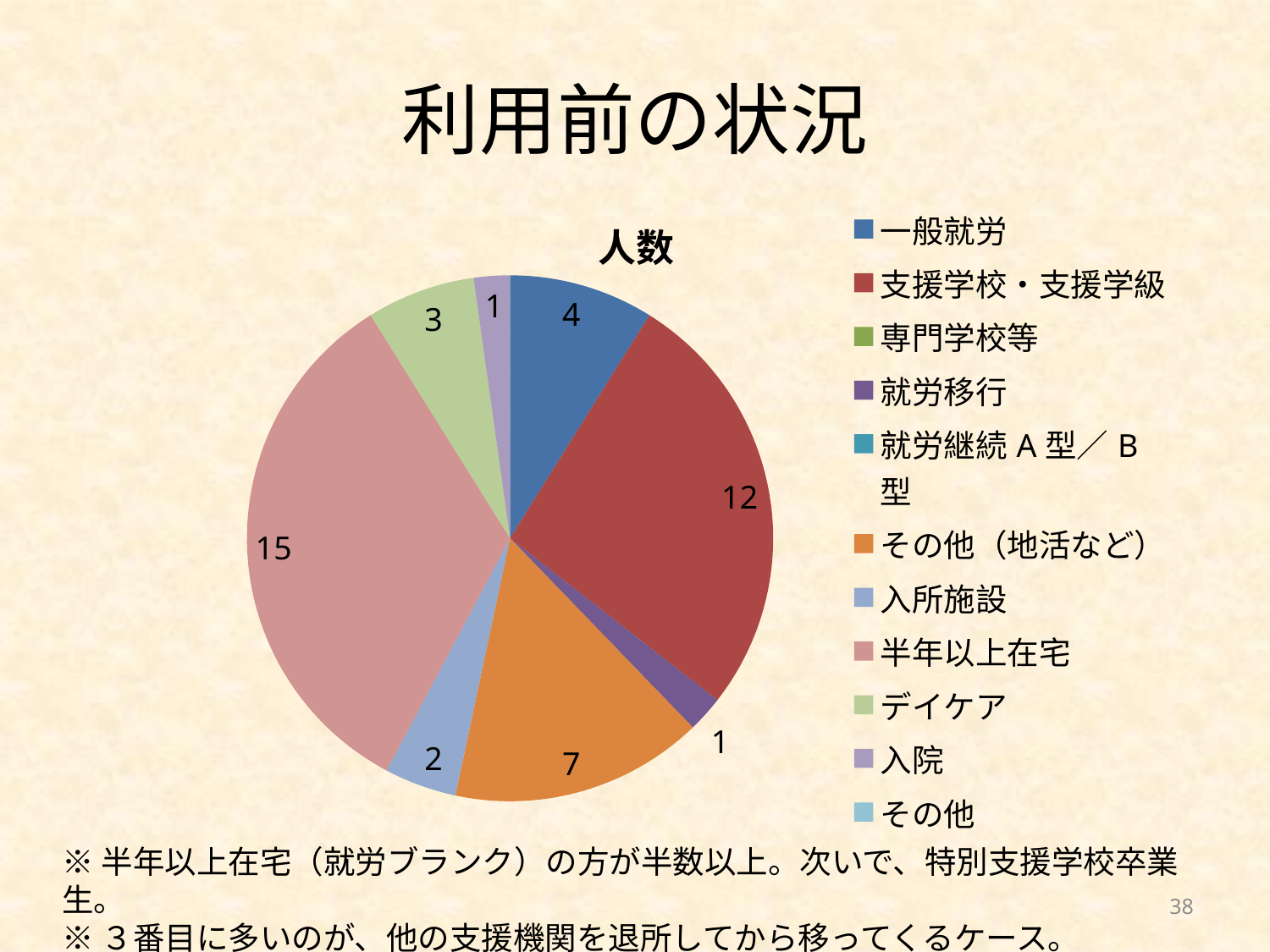
What is the value for 一般就労 in the pie chart? 4 Which category has the largest slice in the pie chart? 半年以上在宅 What is the difference between the values for 半年以上在宅 and 支援学校・支援学級? 3 What kind of chart is shown on the slide? pie chart Which is larger, the value for 一般就労 or the value for デイケア? 一般就労 What is the value for デイケア in the pie chart? 3 How many entries does the legend of the pie chart list? 11 What is the title of the pie chart? 人数 What is the value for 半年以上在宅 in the pie chart? 15 What is the value for 入所施設 in the pie chart? 2 What is the value for 支援学校・支援学級 in the pie chart? 12 What is the value for その他（地活など） in the pie chart? 7